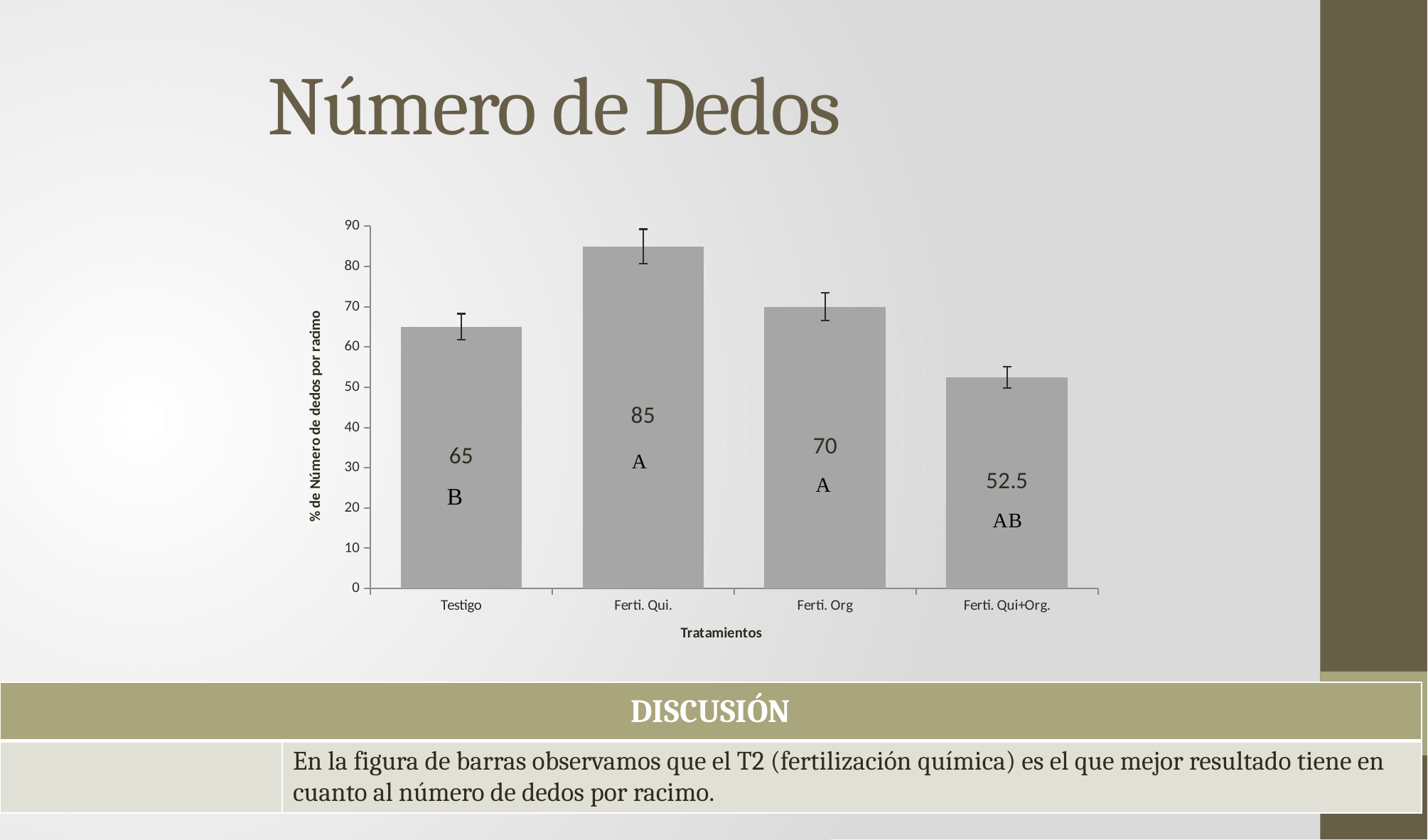
Which treatment has the lowest value? Ferti. Qui+Org. What kind of chart is shown on the slide? Bar chart What is the value for Testigo? 65 What is the difference between the values for Ferti. Qui. and Testigo? 20 What is the value for Ferti. Qui.? 85 What is the value for Ferti. Qui+Org.? 52.5 What is the difference between the values for Ferti. Org and Ferti. Qui+Org.? 17.5 How many treatments are shown on the x axis? 4 What is the label of the x axis? Tratamientos What is the value for Ferti. Org? 70 Which treatment has the highest value? Ferti. Qui. Which is larger, the value for Testigo or the value for Ferti. Org? Ferti. Org